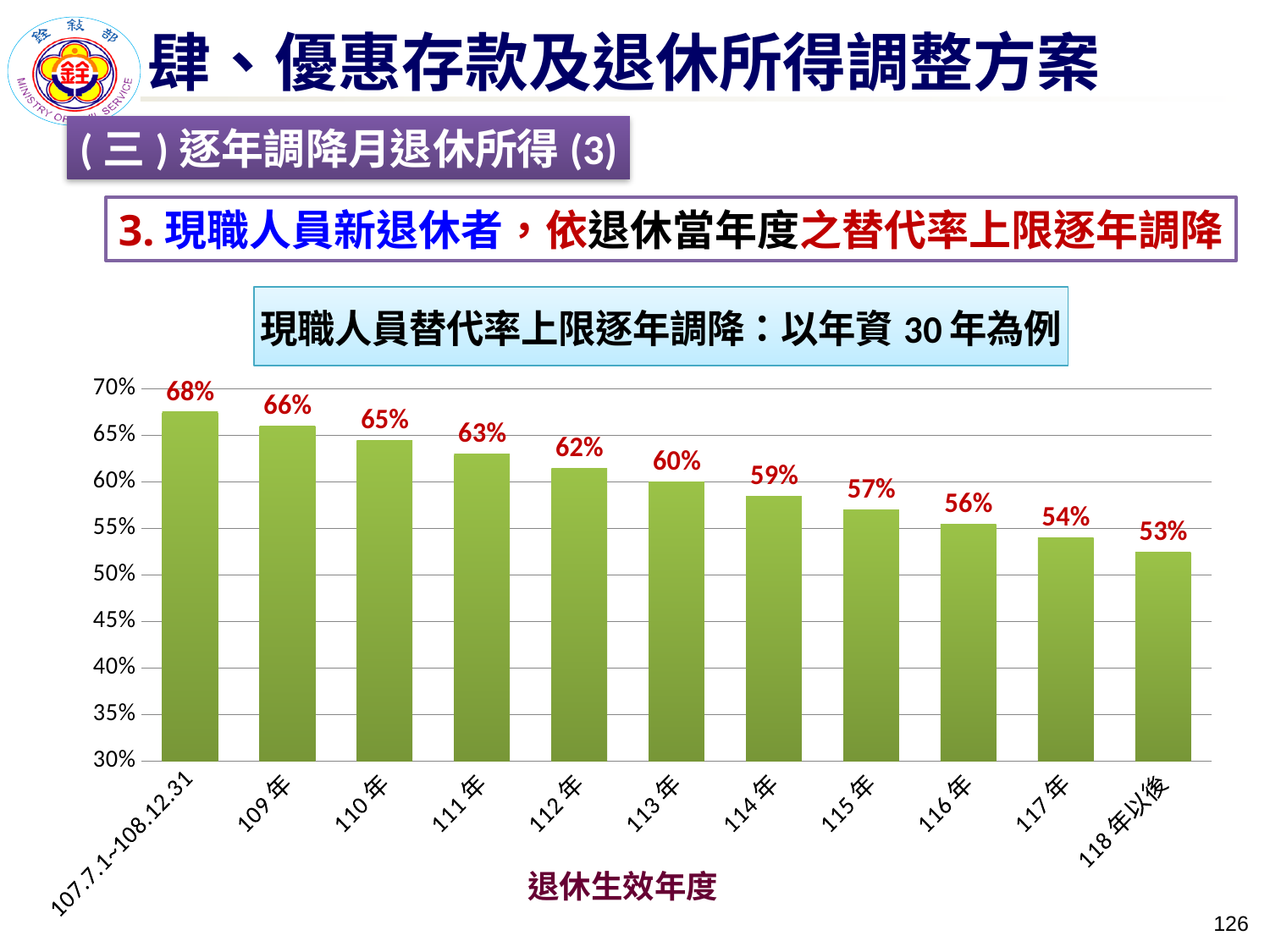
What kind of chart is this? Bar chart What is the x-axis title of the chart? 退休生效年度 Which category has the highest value? 107.7.1~108.12.31 Which is larger, the value for 111年 or the value for 115年? 111年 What is the value shown for 107.7.1~108.12.31? 68% What is the value shown for 113年? 60% What is the difference between the values for 107.7.1~108.12.31 and 118年以後? 15% What is the replacement rate cap shown for 109年? 66% Do the values rise or fall from left to right along the x axis? Fall How many categories are shown on the x axis? 11 What is the value shown for 118年以後? 53% Which category has the lowest value? 118年以後